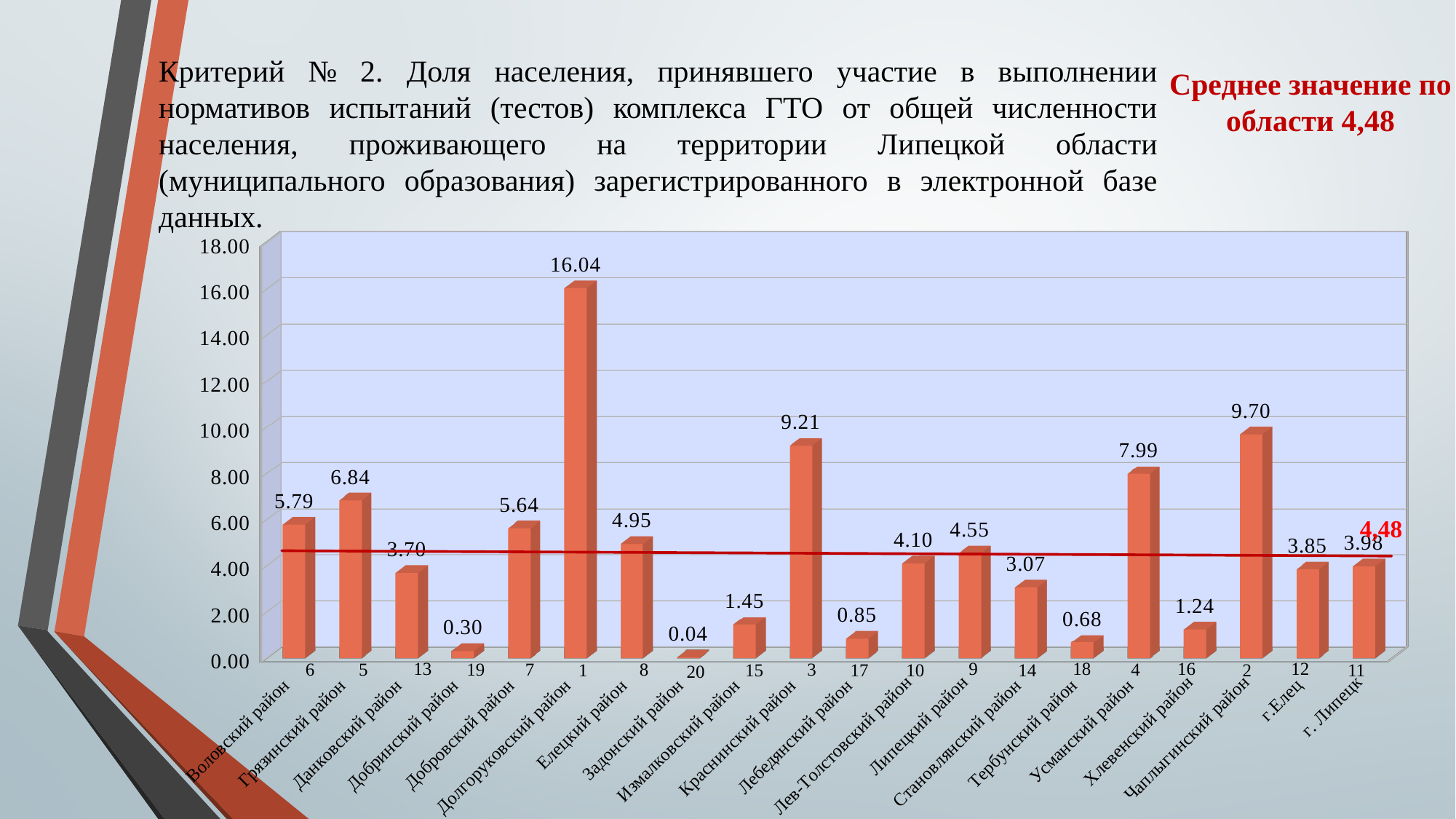
Which district has the lowest value on the chart? Задонский район What kind of chart is shown on the slide? bar chart How many districts/cities are shown on the chart? 20 What is the difference between the values for Краснинский район and Усманский район? 1.22 Is the value for Усманский район greater or less than 6.00? greater What value is shown for г. Липецк? 3.98 What value is shown for Долгоруковский район? 16.04 Which district has the highest value on the chart? Долгоруковский район What is the regional average value marked by the horizontal line on the chart? 4.48 What value is shown for Тербунский район? 0.68 Which is larger, the value for Грязинский район or the value for Воловский район? Грязинский район What value is shown for Чаплыгинский район? 9.70